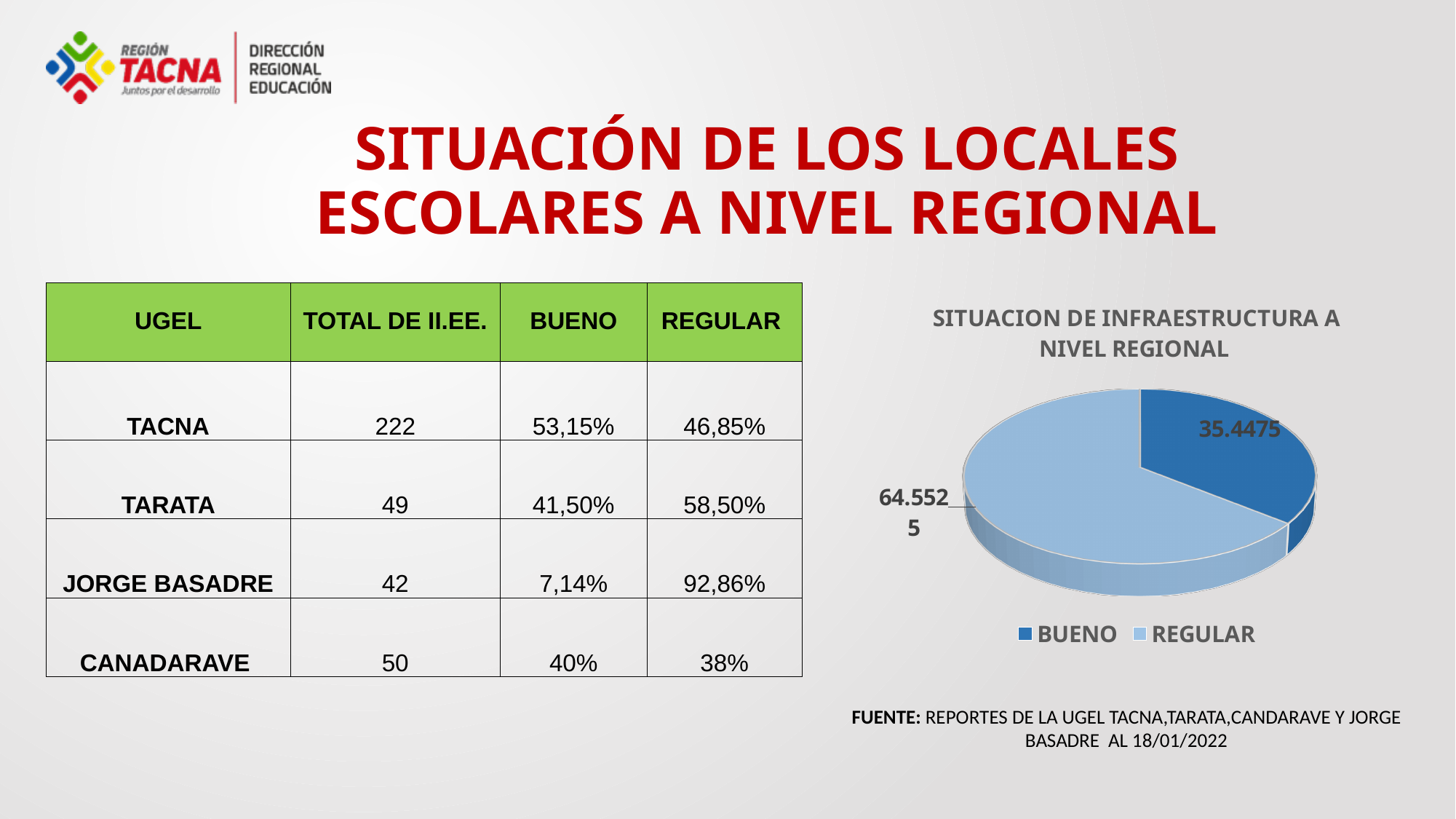
How many entries does the legend of the pie chart list? 2 What kind of chart is shown on the slide? Pie chart Which slice of the pie chart is the largest? REGULAR In the pie chart, what is the value shown for BUENO? 35.4475 How many slices does the pie chart have? 2 In the pie chart, what is the value shown for REGULAR? 64.5525 In the pie chart, which is larger, BUENO or REGULAR? REGULAR What is the total of the two values shown in the pie chart? 100 What is the difference between the REGULAR and BUENO values in the pie chart? 29.105 Which slice of the pie chart is the smallest? BUENO What is the title of the pie chart? SITUACION DE INFRAESTRUCTURA A NIVEL REGIONAL Which legend entry in the pie chart is shown in dark blue? BUENO